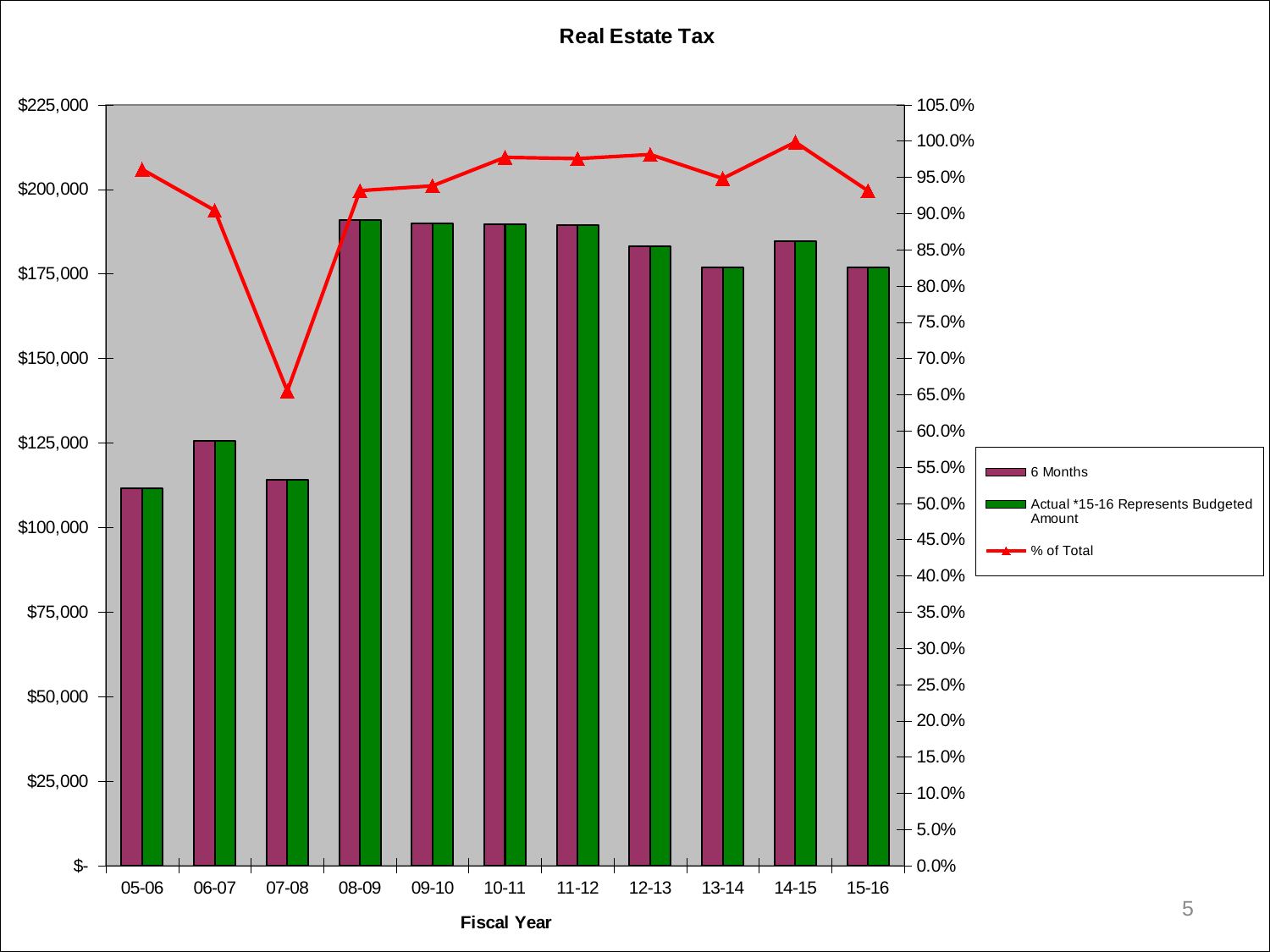
Which fiscal year has the larger Actual value, 05-06 or 08-09? 08-09 Is the % of Total value for 07-08 greater or less than 70.0%? less Which fiscal year has the lowest % of Total value? 07-08 Which fiscal year has the highest % of Total value? 14-15 What is the title of the chart? Real Estate Tax Is the % of Total value for 14-15 greater or less than 95.0%? greater What kind of chart is this? Bar chart with a line series How many series does the legend list? 3 Is the 6 Months value for 05-06 greater or less than $125,000? less How many fiscal years are shown on the x axis? 11 Does the % of Total line rise or fall from 07-08 to 08-09? rise